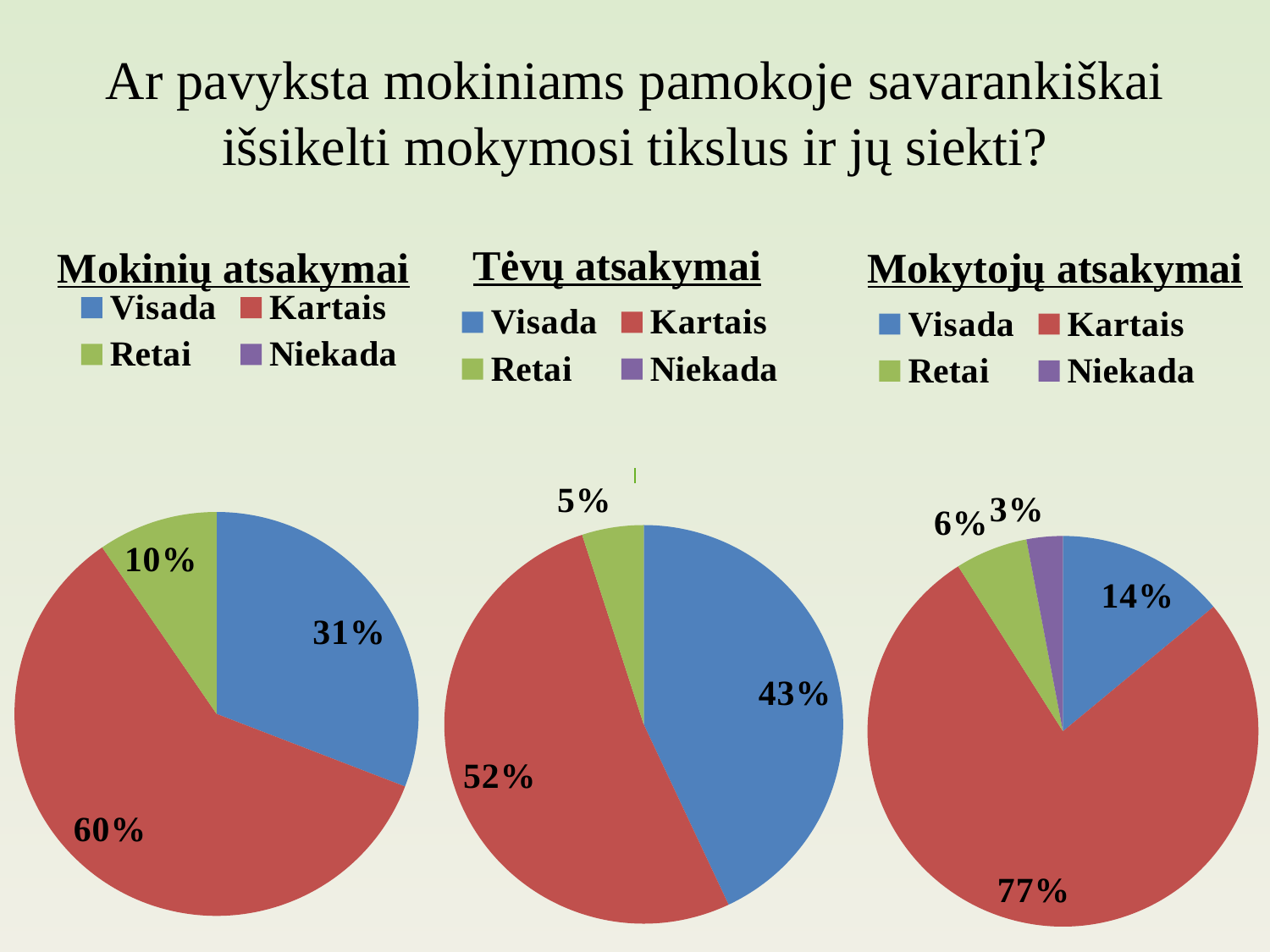
In the 'Mokytojų atsakymai' chart, which category has the smallest slice? Niekada In the 'Tėvų atsakymai' chart, what percentage is shown for Retai? 5% What type of chart is used for 'Mokytojų atsakymai'? Pie chart In the 'Mokinių atsakymai' chart, what percentage is shown for Kartais? 60% In the 'Mokytojų atsakymai' chart, what percentage is shown for Niekada? 3% What colour represents Kartais in the legends of the three charts? Red Which chart shows the highest percentage for Kartais: 'Mokinių atsakymai', 'Tėvų atsakymai' or 'Mokytojų atsakymai'? Mokytojų atsakymai In the 'Mokytojų atsakymai' chart, which category has the largest slice? Kartais In the 'Tėvų atsakymai' chart, what is the difference between the Kartais and Visada percentages? 9% In the 'Mokinių atsakymai' chart, which is larger: Visada or Retai? Visada How many entries does the legend of the 'Tėvų atsakymai' chart list? 4 In the 'Mokinių atsakymai' chart, what percentage is shown for Visada? 31%